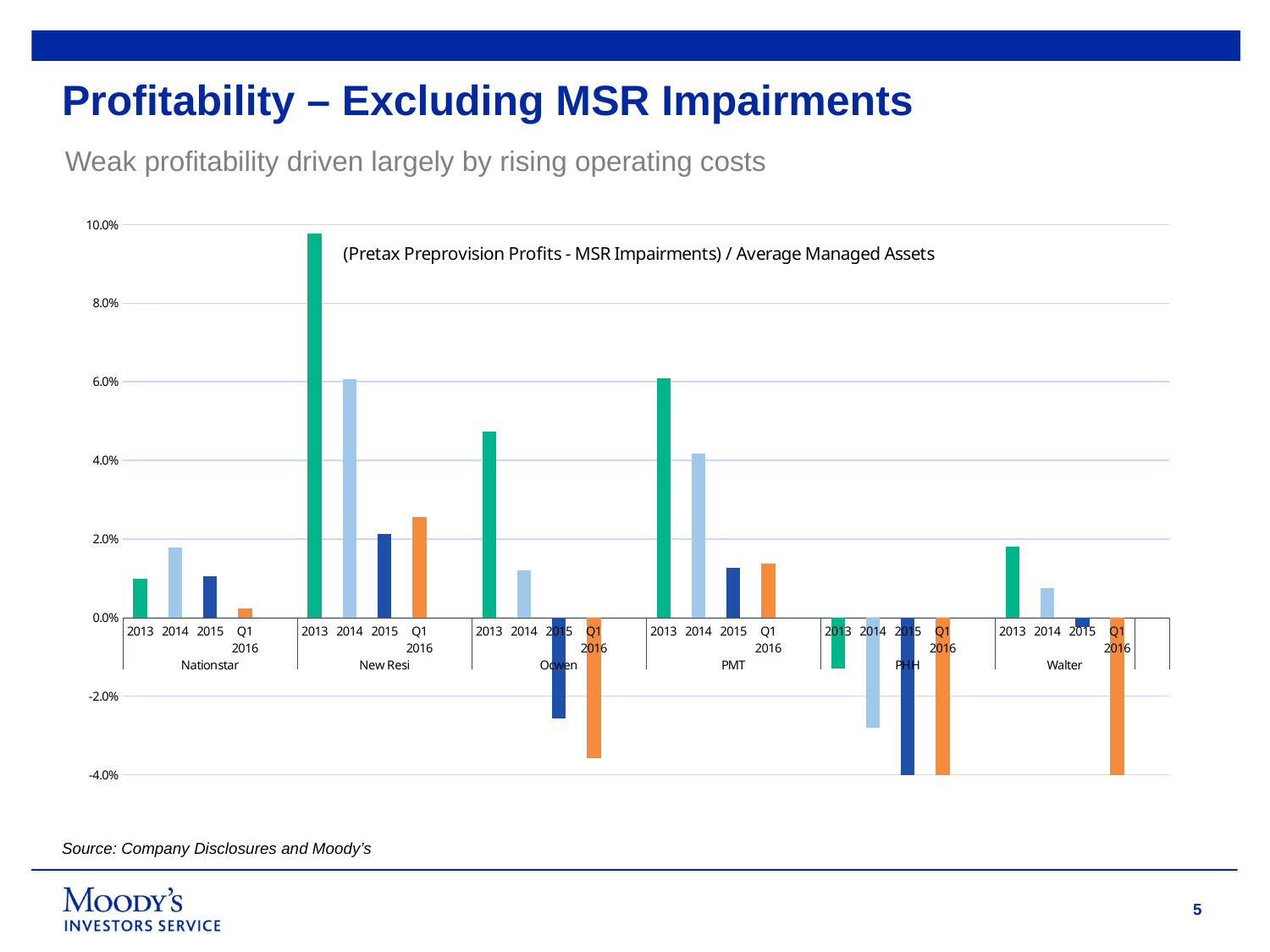
For Walter, do the values rise or fall from 2013 to Q1 2016? Fall Is the value for Ocwen in Q1 2016 greater or less than -2.0%? less How many periods are plotted for each company in the chart? 4 What kind of chart is shown on the slide? Bar chart Is the value for PMT in 2013 greater or less than 4.0%? greater Which is larger, the 2013 value for New Resi or the 2013 value for PMT? New Resi Is the value for Nationstar in 2014 greater or less than 2.0%? less Which company and period has the highest value in the chart? New Resi, 2013 What formula is shown as the label inside the chart area? (Pretax Preprovision Profits - MSR Impairments) / Average Managed Assets How many companies are shown along the x axis of the chart? 6 Which period has the lowest value for Ocwen? Q1 2016